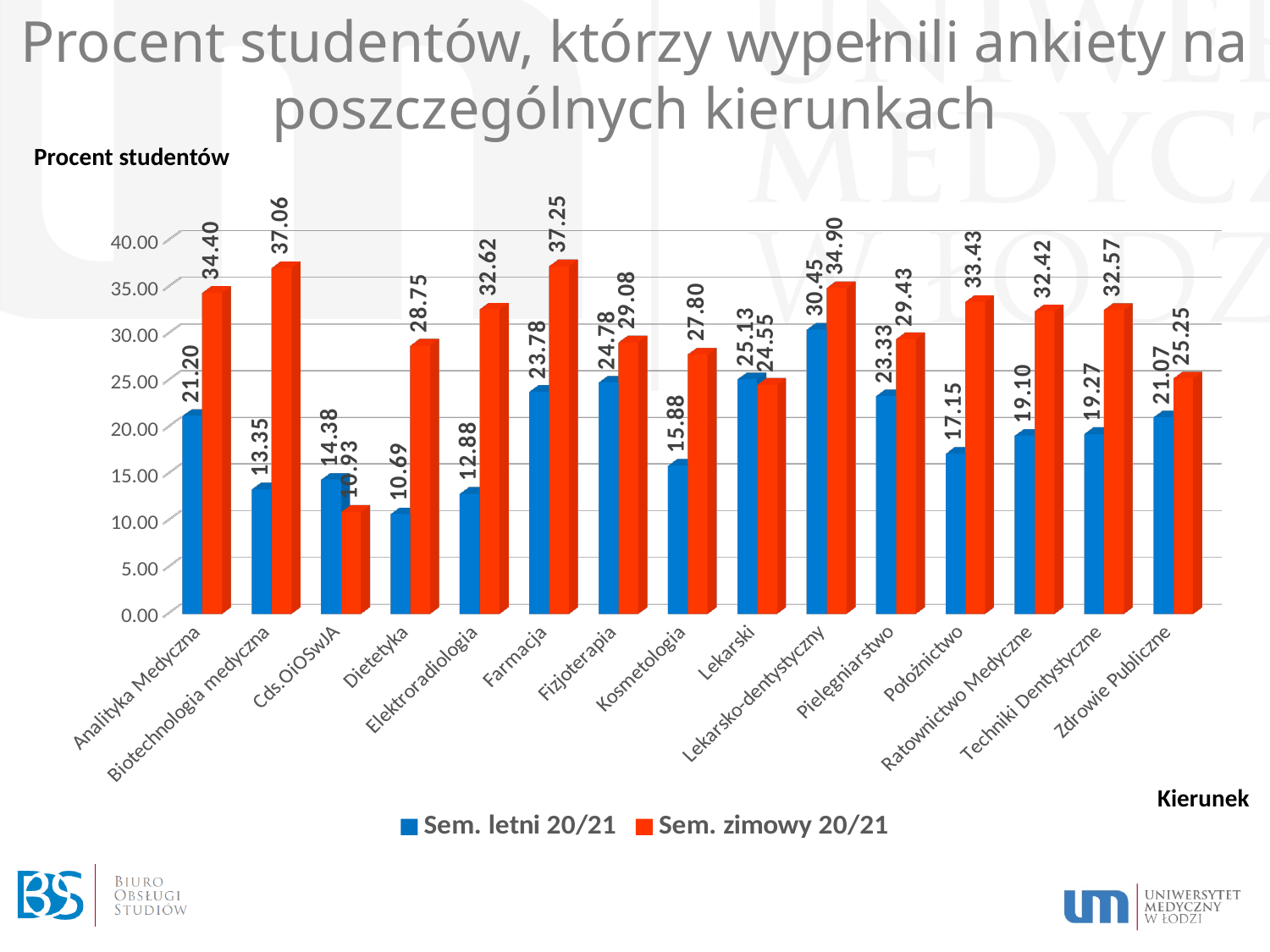
Is the Sem. zimowy 20/21 value for Biotechnologia medyczna greater or less than 35.00? greater Which kierunek has the lowest value in the Sem. zimowy 20/21 series? Cds.OiOSwJA What is the difference between the Sem. zimowy 20/21 and Sem. letni 20/21 values for Dietetyka? 18.06 What is the value for Farmacja in the Sem. zimowy 20/21 series? 37.25 For Lekarski, which series has the larger value: Sem. letni 20/21 or Sem. zimowy 20/21? Sem. letni 20/21 How many kierunki (categories) are shown on the x axis? 15 Which kierunek has the highest value in the Sem. letni 20/21 series? Lekarsko-dentystyczny How many series does the legend list? 2 What is the value for Położnictwo in the Sem. zimowy 20/21 series? 33.43 What kind of chart is shown on the slide? Bar chart Which kierunek has the lowest value in the Sem. letni 20/21 series? Dietetyka What is the value for Dietetyka in the Sem. letni 20/21 series? 10.69